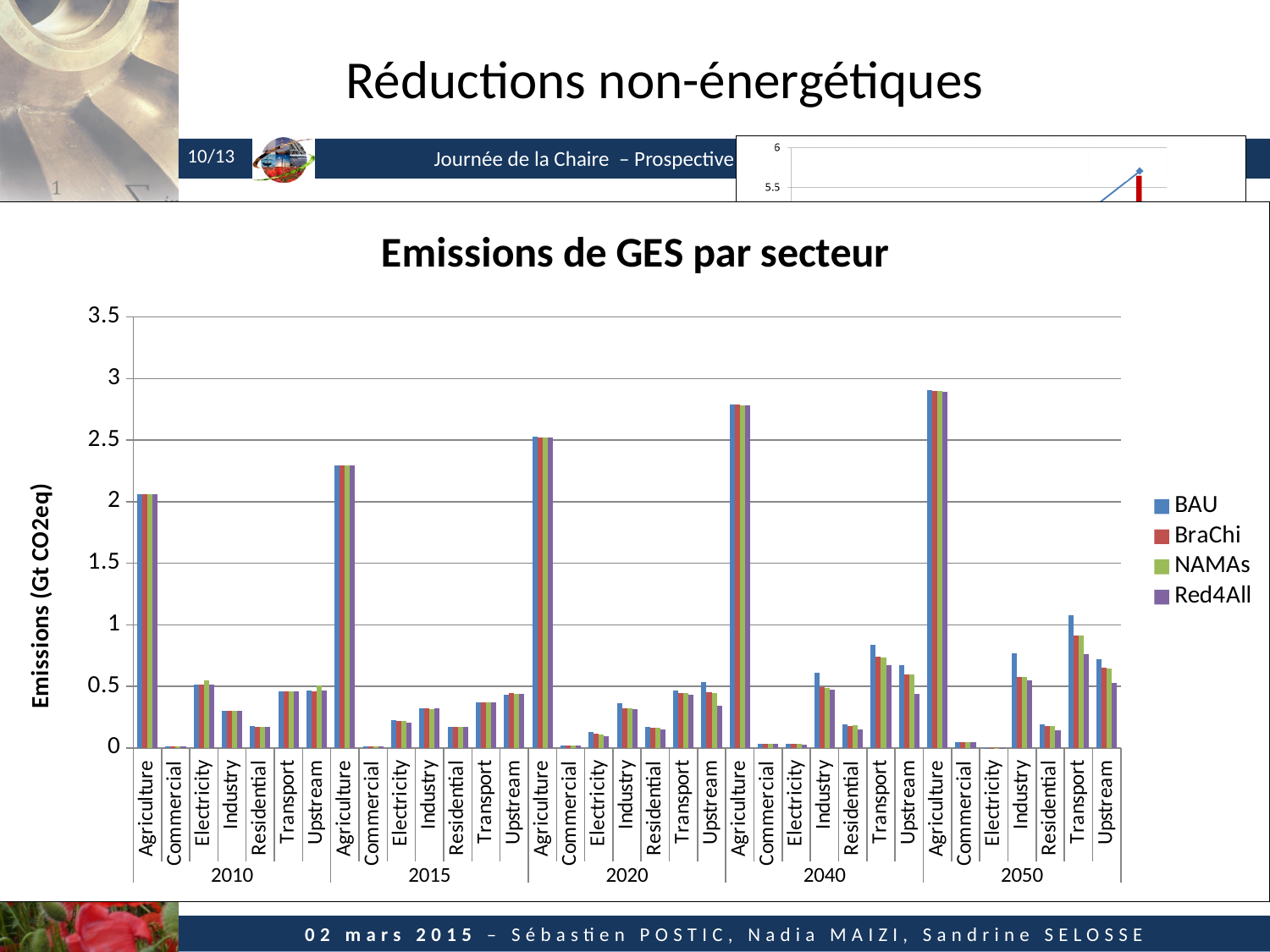
What is the y-axis label of the 'Emissions de GES par secteur' chart? Emissions (Gt CO2eq) What kind of chart is 'Emissions de GES par secteur'? bar chart In the 'Emissions de GES par secteur' chart, is the BAU value for Agriculture in 2050 greater or less than 3? less How many years are shown along the x axis of the 'Emissions de GES par secteur' chart? 5 Which series are listed in the legend of the 'Emissions de GES par secteur' chart? BAU, BraChi, NAMAs, Red4All In the 'Emissions de GES par secteur' chart, is the BAU value for Agriculture in 2010 greater or less than 2? greater How many sectors are shown for each year in the 'Emissions de GES par secteur' chart? 7 How many series does the legend of the 'Emissions de GES par secteur' chart list? 4 In the 'Emissions de GES par secteur' chart, which is larger for Transport in 2050: the BAU value or the Red4All value? BAU In the 'Emissions de GES par secteur' chart, is the BAU value for Transport in 2050 greater or less than 1? greater In the 'Emissions de GES par secteur' chart, which sector has the highest emissions in 2050? Agriculture In the 'Emissions de GES par secteur' chart, which sector has the lowest emissions in 2010? Commercial